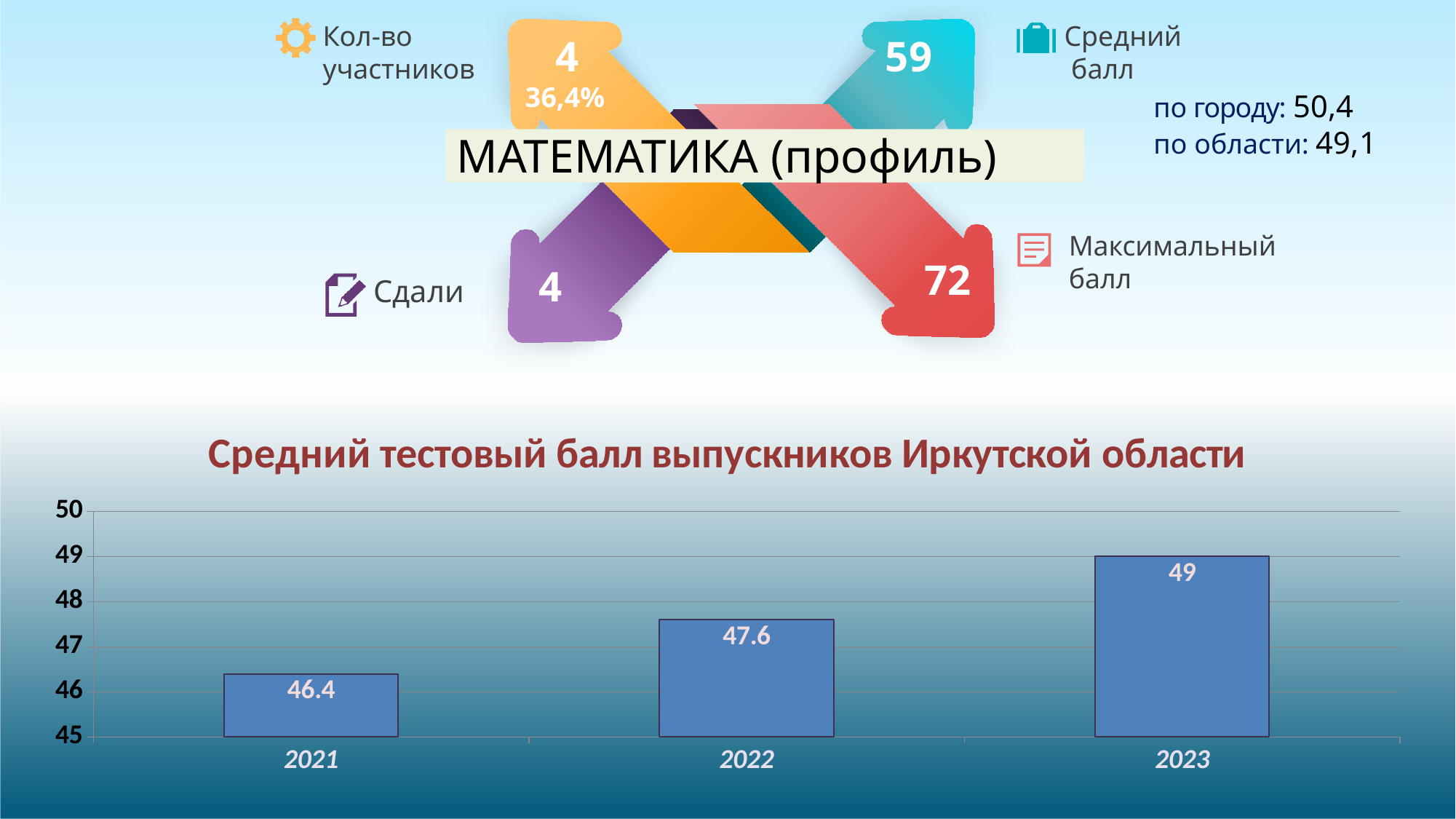
Do the values rise or fall from 2021 to 2023? rise What is the value for 2021 in the chart? 46.4 How many years are shown in the chart? 3 Which year has the highest value in the chart? 2023 What is the difference between the values for 2023 and 2021? 2.6 Which year has the lowest value in the chart? 2021 What is the difference between the values for 2022 and 2021? 1.2 What kind of chart is shown on the slide? bar chart What is the value for 2023 in the chart? 49 Is the value for 2022 greater or less than 48? less Which is larger, the value for 2022 or the value for 2023? 2023 What is the value for 2022 in the chart? 47.6